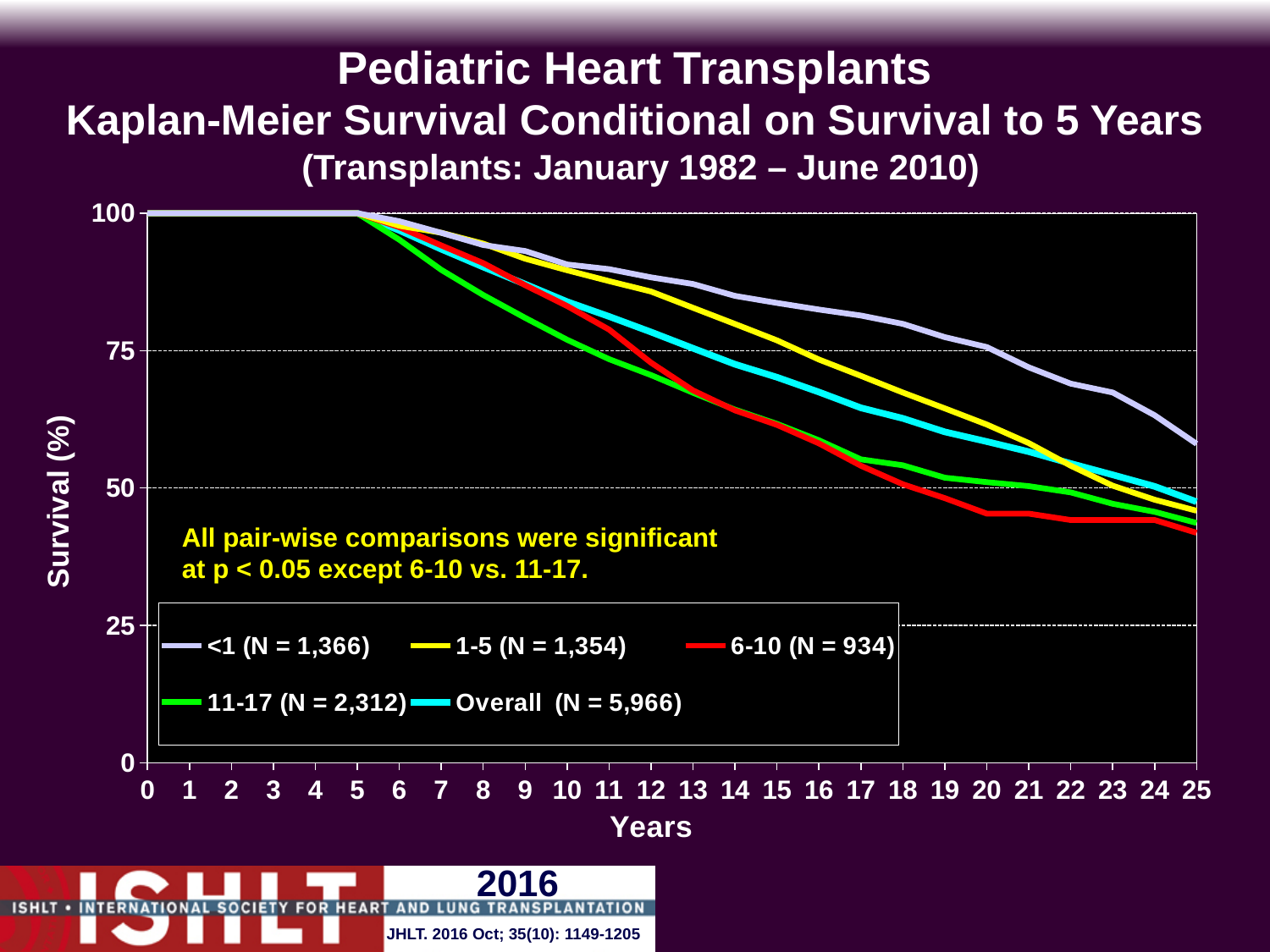
Do the survival curves rise or fall as years increase beyond 5? fall How many series does the legend list? 5 What kind of chart is shown on the slide? line chart What is the N for the Overall group shown in the legend? 5,966 Which age group has the highest survival at 25 years? <1 Is the survival for the 11-17 group at 13 years greater or less than 75? less Which age group has the lowest survival at 25 years? 6-10 At 10 years, which group has higher survival: 1-5 or 11-17? 1-5 Is the survival for the <1 group at 15 years greater or less than 75? greater Is the survival for the <1 group at 25 years greater or less than 50? greater What is the survival (%) for all groups at 5 years? 100